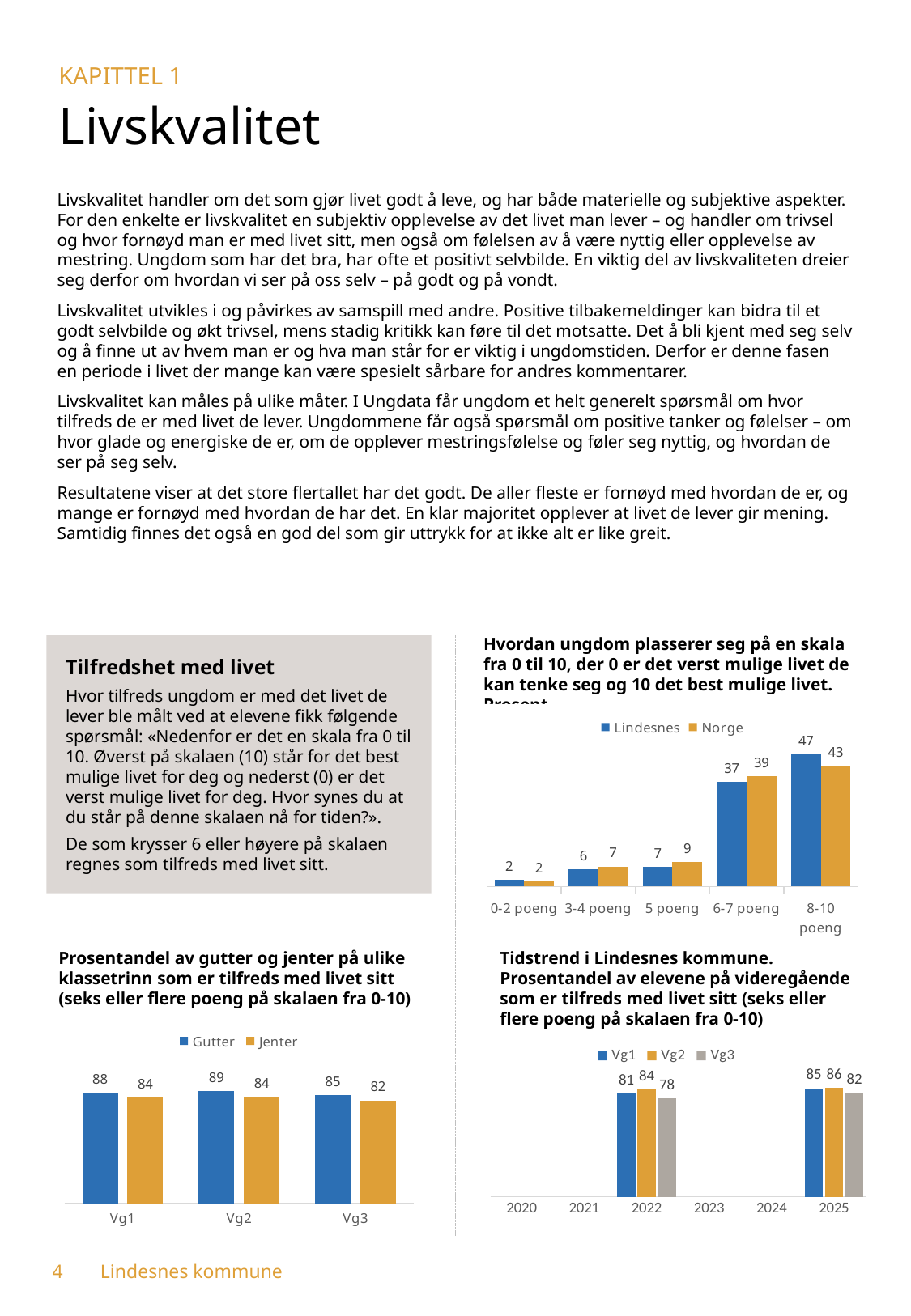
In the bottom-right chart (Tidstrend i Lindesnes kommune), what is the value for Vg3 in 2022? 78 In the bottom-left chart (Prosentandel av gutter og jenter på ulike klassetrinn som er tilfreds med livet sitt), which class level has the lowest value for Jenter? Vg3 In the bottom-right chart (Tidstrend i Lindesnes kommune), what is the difference between the Vg1 value in 2025 and in 2022? 4 In the top-right chart (Hvordan ungdom plasserer seg på en skala fra 0 til 10), what is the difference between Lindesnes and Norge in the 8-10 poeng category? 4 In the bottom-left chart (Prosentandel av gutter og jenter på ulike klassetrinn som er tilfreds med livet sitt), which is larger at Vg1: Gutter or Jenter? Gutter In the top-right chart (Hvordan ungdom plasserer seg på en skala fra 0 til 10), which category has the highest value for Lindesnes? 8-10 poeng In the top-right chart (Hvordan ungdom plasserer seg på en skala fra 0 til 10), how many categories are shown on the x axis? 5 In the bottom-left chart (Prosentandel av gutter og jenter på ulike klassetrinn som er tilfreds med livet sitt), what kind of chart is it? Bar chart In the bottom-right chart (Tidstrend i Lindesnes kommune), how many series does the legend list? 3 In the top-right chart (Hvordan ungdom plasserer seg på en skala fra 0 til 10), what is the value for Norge in the 6-7 poeng category? 39 In the bottom-left chart (Prosentandel av gutter og jenter på ulike klassetrinn som er tilfreds med livet sitt), what is the value for Gutter at Vg2? 89 In the top-right chart (Hvordan ungdom plasserer seg på en skala fra 0 til 10), what is the value for Lindesnes in the 8-10 poeng category? 47